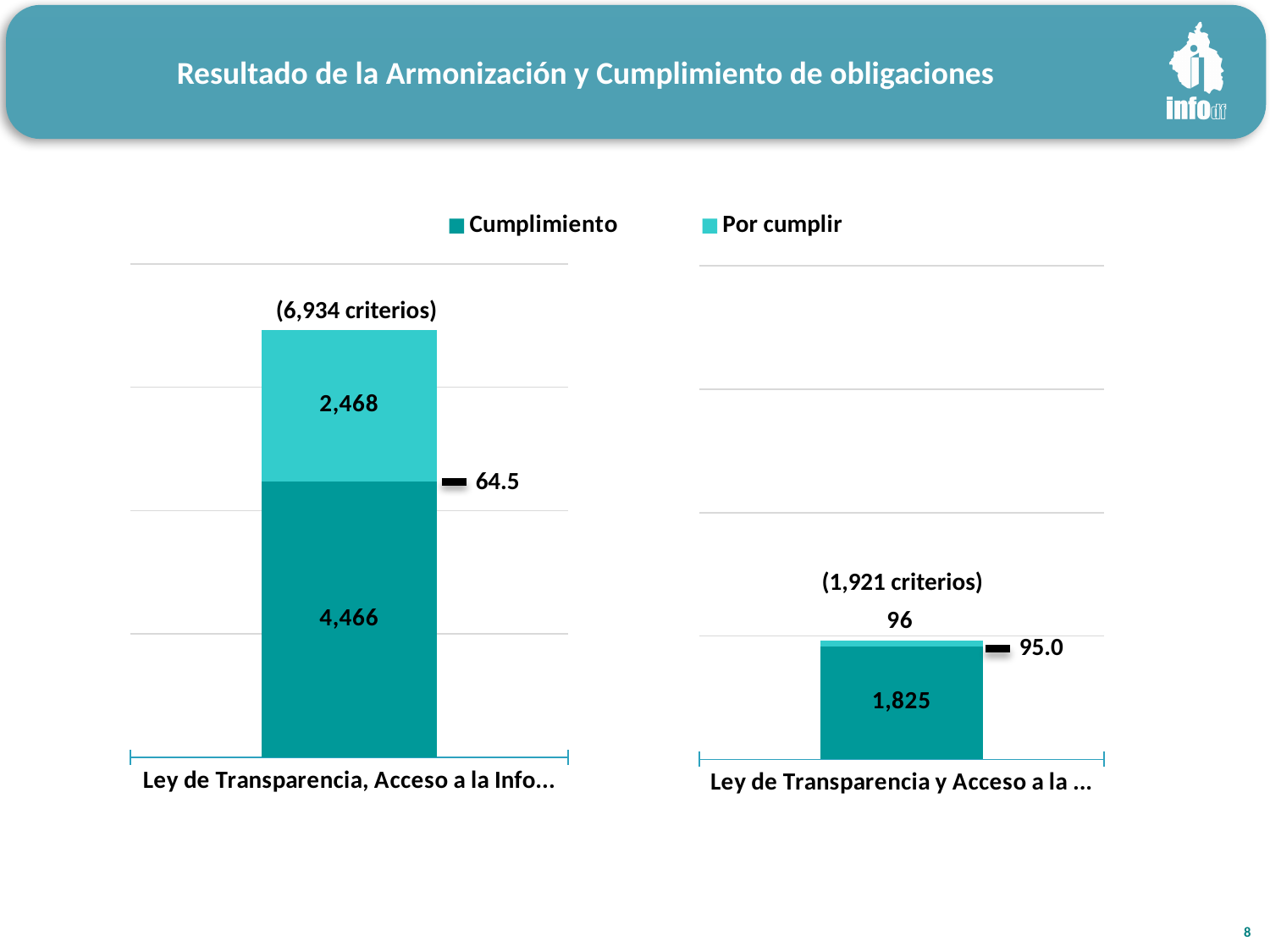
In the left chart, what is the Cumplimiento value? 4,466 In the right chart, what is the difference between the Cumplimiento and Por cumplir values? 1,729 In the right chart, what is the Por cumplir value? 96 In the left chart, which series has the larger value, Cumplimiento or Por cumplir? Cumplimiento How many series does the legend list? 2 In the left chart, what total number of criterios is shown above the stacked bar? 6,934 criterios What value is shown next to the black marker on the left chart? 64.5 In the left chart, what is the Por cumplir value? 2,468 In the right chart, what is the Cumplimiento value? 1,825 What value is shown next to the black marker on the right chart? 95.0 In the left chart, what is the difference between the Cumplimiento and Por cumplir values? 1,998 In the right chart, what total number of criterios is shown above the stacked bar? 1,921 criterios